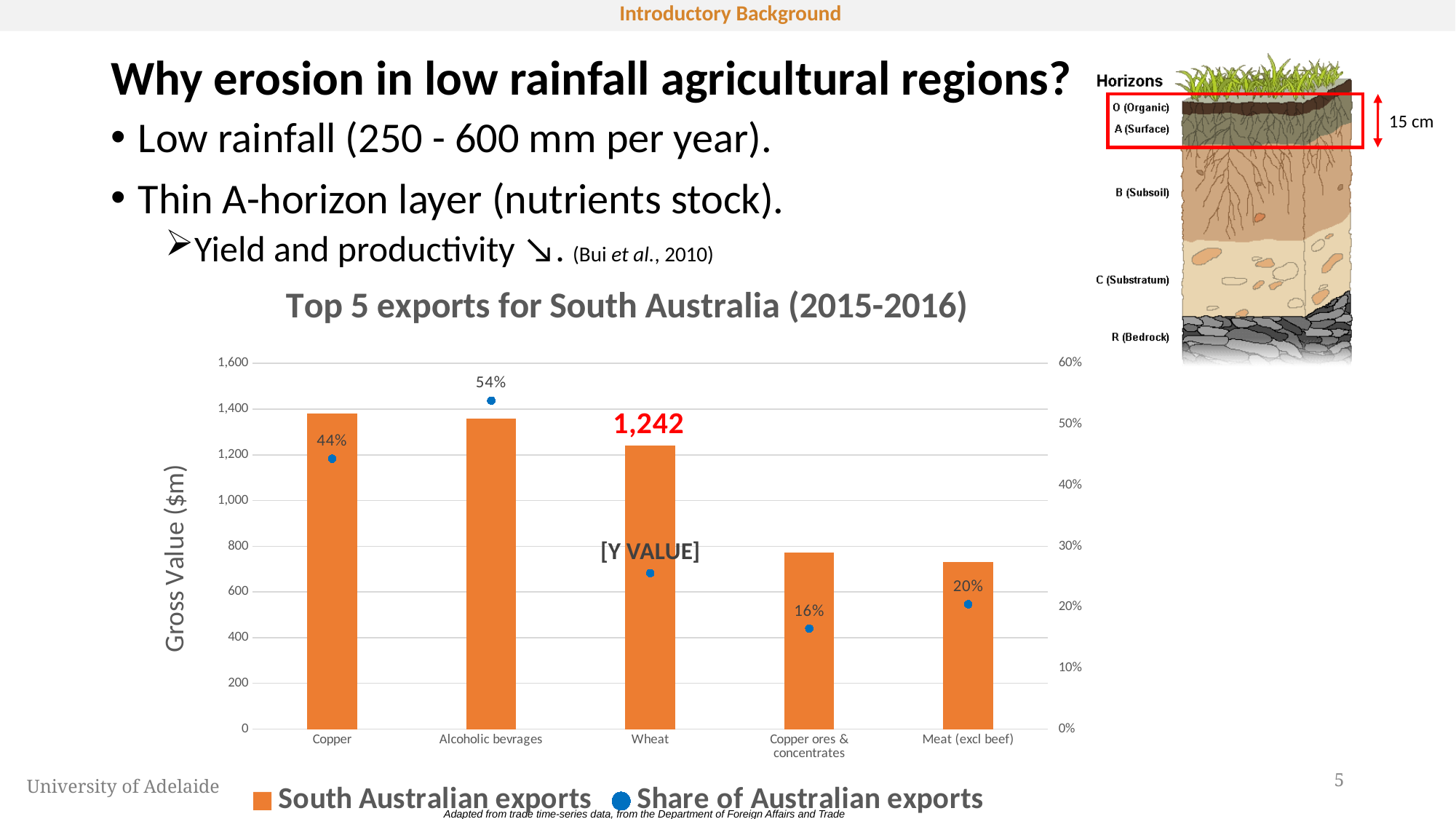
How many series does the chart legend list? 2 What share of Australian exports does Copper account for, according to the chart? 44% How many export categories are shown on the chart? 5 What share of Australian exports is shown for Alcoholic bevrages? 54% Which has a larger South Australian export value, Wheat or Copper ores & concentrates? Wheat What share of Australian exports is shown for Meat (excl beef)? 20% Is the South Australian export value for Meat (excl beef) greater or less than 800? less What is the gross value of Wheat exports shown on the chart? 1,242 Which category has the highest share of Australian exports? Alcoholic bevrages What is the label on the left vertical axis of the chart? Gross Value ($m) What is the difference between the share of Australian exports for Alcoholic bevrages and for Copper? 10 percentage points Which category has the lowest share of Australian exports? Copper ores & concentrates